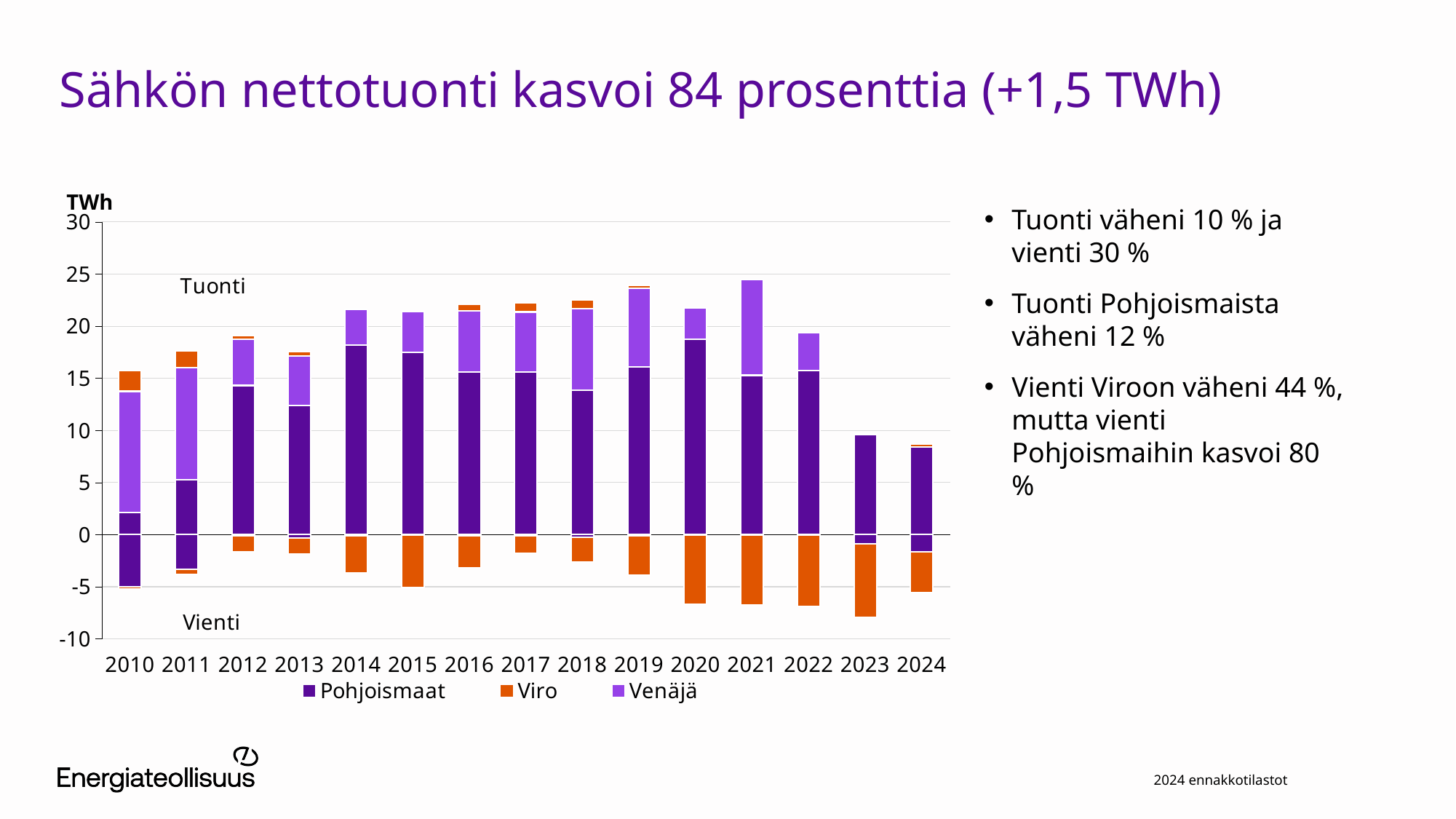
Is the Pohjoismaat import value for 2015 greater or less than 15 TWh? greater How many series does the chart legend list? 3 Is the Pohjoismaat import value for 2014 greater or less than 15 TWh? greater What kind of chart is shown on the slide? Stacked bar chart Is the total import (positive stack) for 2021 greater or less than 20 TWh? greater Which series in the chart is shown in orange? Viro Does the Pohjoismaat import value rise or fall from 2022 to 2024? fall Which is the last year in which a Venäjä segment appears in the chart? 2022 How many years are shown on the x axis of the chart? 15 What unit is shown on the vertical axis of the chart? TWh